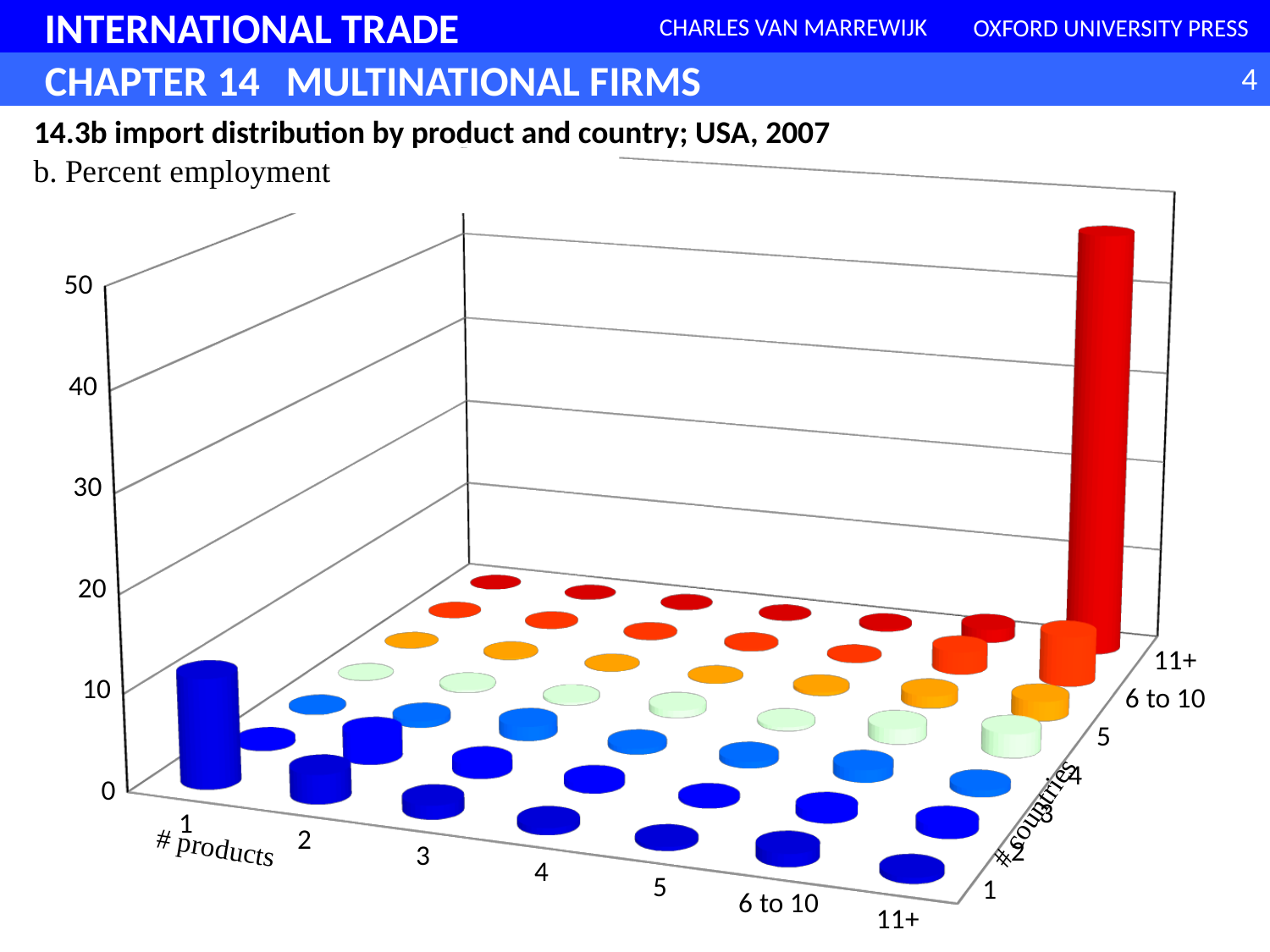
Is the value for 11+ products and 11+ countries greater or less than 40? greater Which is larger: the bar for 11+ products and 11+ countries, or the bar for 1 product and 1 country? 11+ products and 11+ countries Is the value for 6 to 10 products and 6 to 10 countries greater or less than 10? less What is the highest tick value shown on the vertical axis? 50 How many categories are shown on the # products axis? 7 Is the value for 1 product and 1 country greater or less than 20? less How many categories are shown on the # countries axis? 7 Which combination of # products and # countries has the highest bar? 11+ products, 11+ countries What kind of chart is shown on the slide? 3D bar chart What is the title of the chart? 14.3b import distribution by product and country; USA, 2007